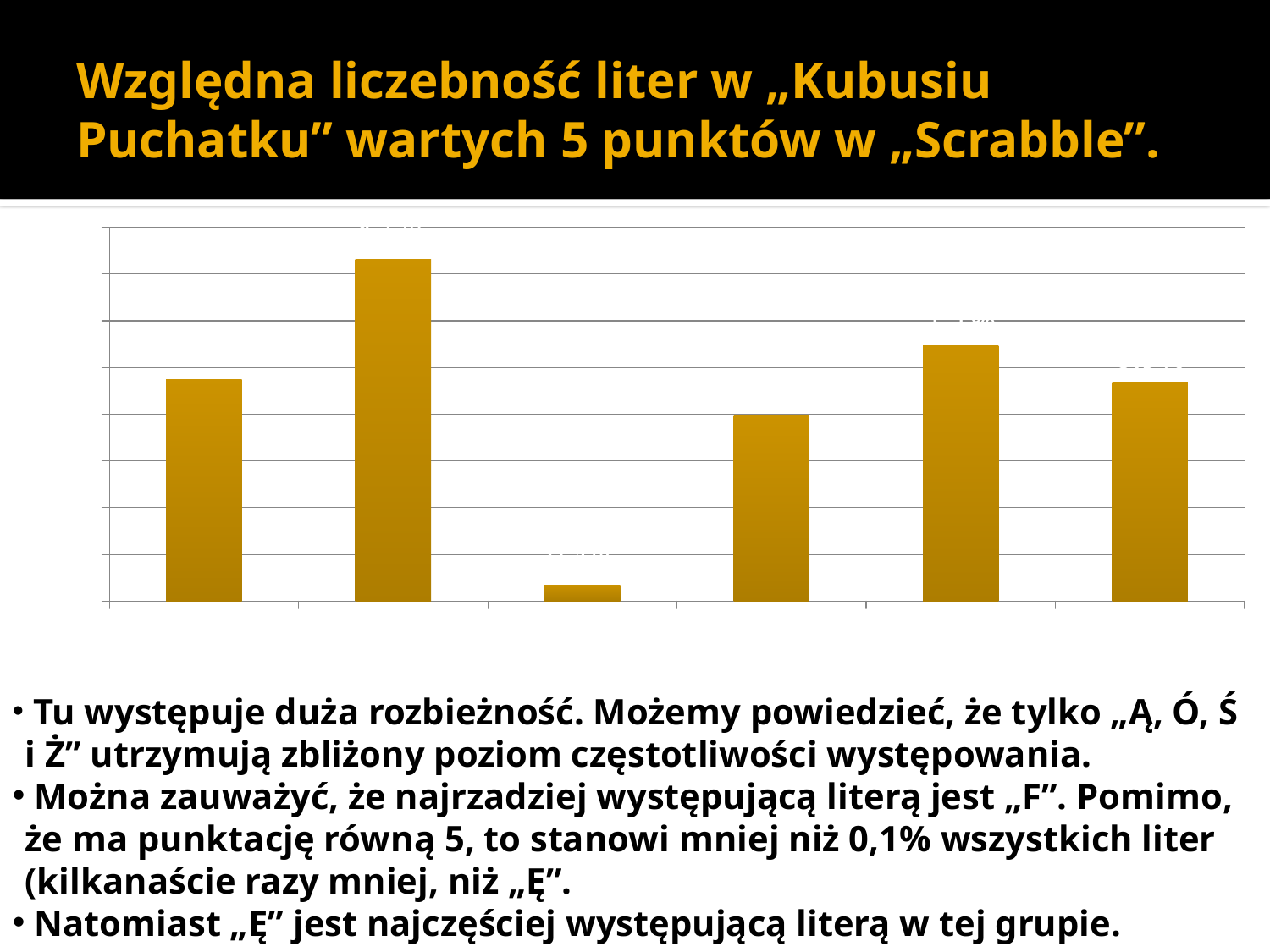
What colour are the bars in the chart? gold How many bars does the chart contain? 6 What kind of chart is shown on the slide? bar chart Do the bar heights rise steadily, fall steadily, or fluctuate from left to right across the chart? fluctuate Which bar in the chart is the tallest, counting from the left? the second bar Which is taller in the chart: the first bar from the left or the third bar from the left? the first bar What is the title of the slide containing the chart? Względna liczebność liter w „Kubusiu Puchatku” wartych 5 punktów w „Scrabble”. Which is taller in the chart: the first bar from the left or the fourth bar from the left? the first bar Which bar in the chart is the shortest, counting from the left? the third bar Which is taller in the chart: the fifth bar from the left or the sixth bar from the left? the fifth bar